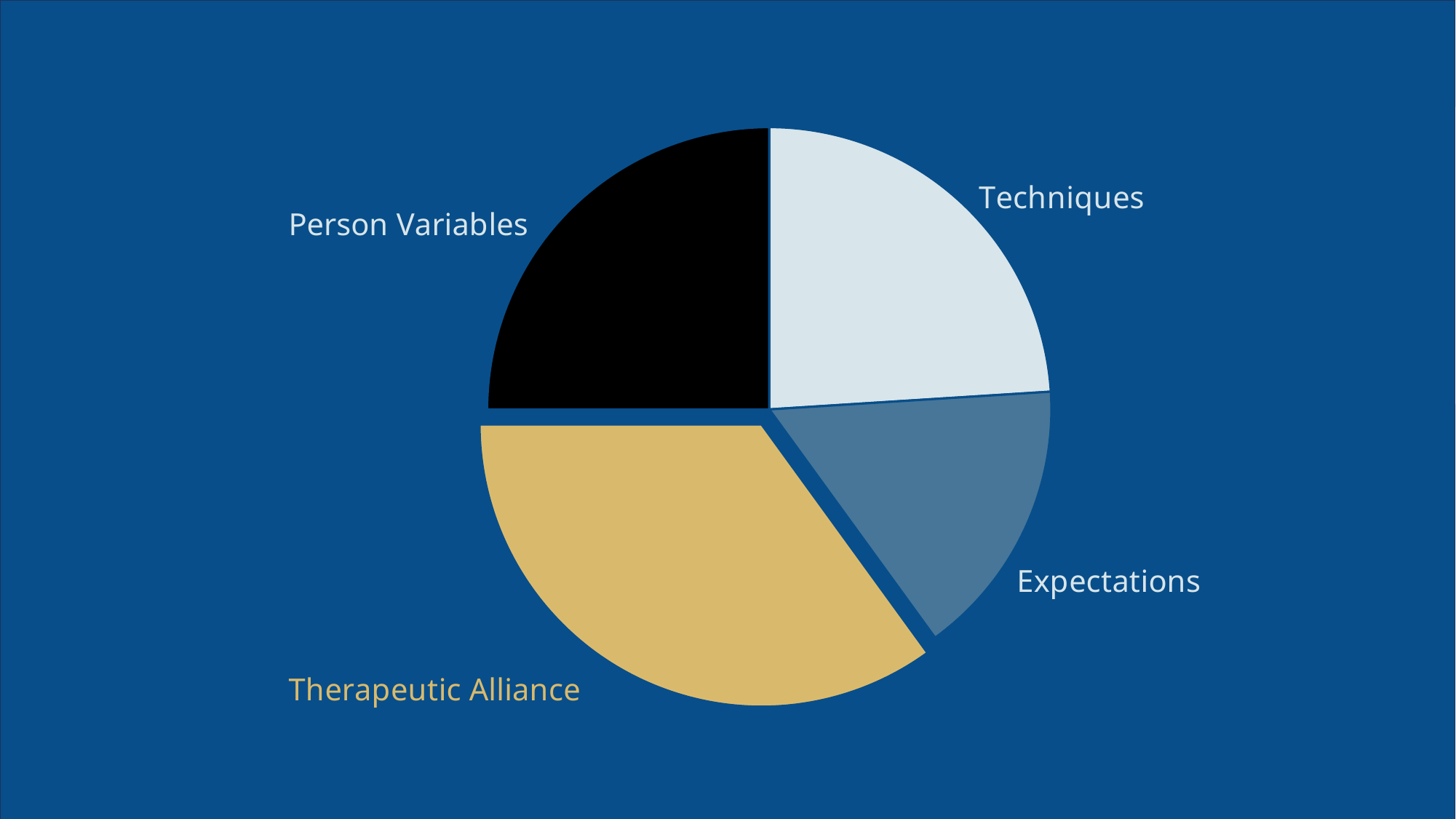
Which slice is larger, Therapeutic Alliance or Techniques? Therapeutic Alliance How many slices does the pie chart have? 4 Which slice of the pie chart is coloured gold? Therapeutic Alliance Which slice of the pie chart is the smallest? Expectations Which slice is larger, Expectations or Person Variables? Person Variables Which slice of the pie chart is the largest? Therapeutic Alliance Which slice of the pie chart is coloured black? Person Variables Which slice is larger, Expectations or Therapeutic Alliance? Therapeutic Alliance What kind of chart is shown on the slide? pie chart